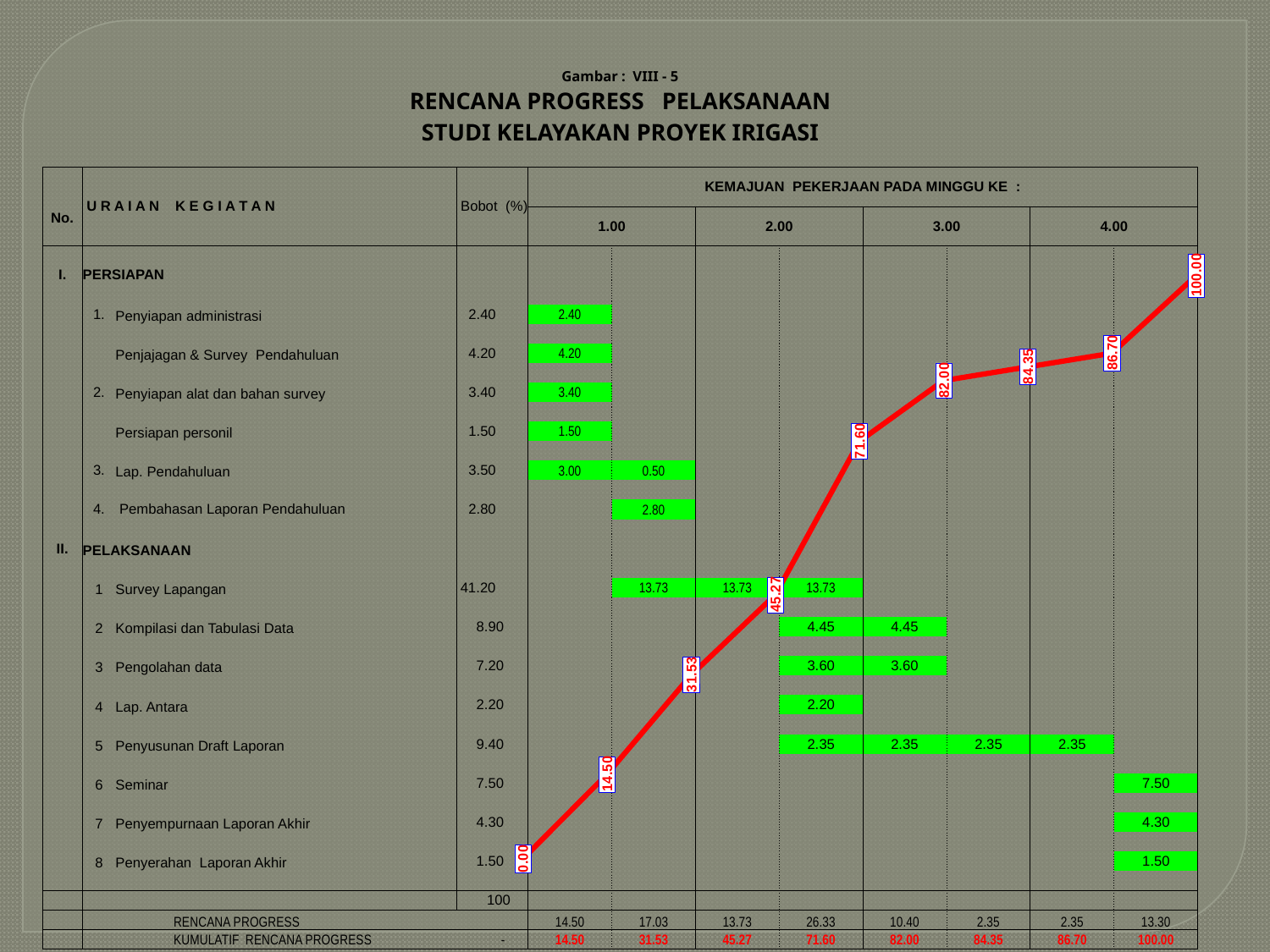
How many weeks (MINGGU KE) are shown along the top of the chart? 4 What is the cumulative planned progress value labelled on the red line at the end of week 3.00? 84.35 Which activity has the highest Bobot (%)? Survey Lapangan What is the RENCANA PROGRESS value for the first half of week 1.00? 14.50 What is the total of the Bobot (%) column? 100 What is the final cumulative planned progress value at the end of week 4.00? 100.00 What is the cumulative planned progress (KUMULATIF RENCANA PROGRESS) at the end of week 2.00? 71.60 Which has the larger Bobot (%): Seminar or Penyempurnaan Laporan Akhir? Seminar What kind of chart is the red cumulative progress curve? line chart What is the difference between the cumulative planned progress at the end of week 2.00 (71.60) and at the middle of week 2.00 (45.27)? 26.33 Does the red cumulative progress line rise or fall from week 1.00 to week 4.00? rises What is the Bobot (%) for Survey Lapangan? 41.20